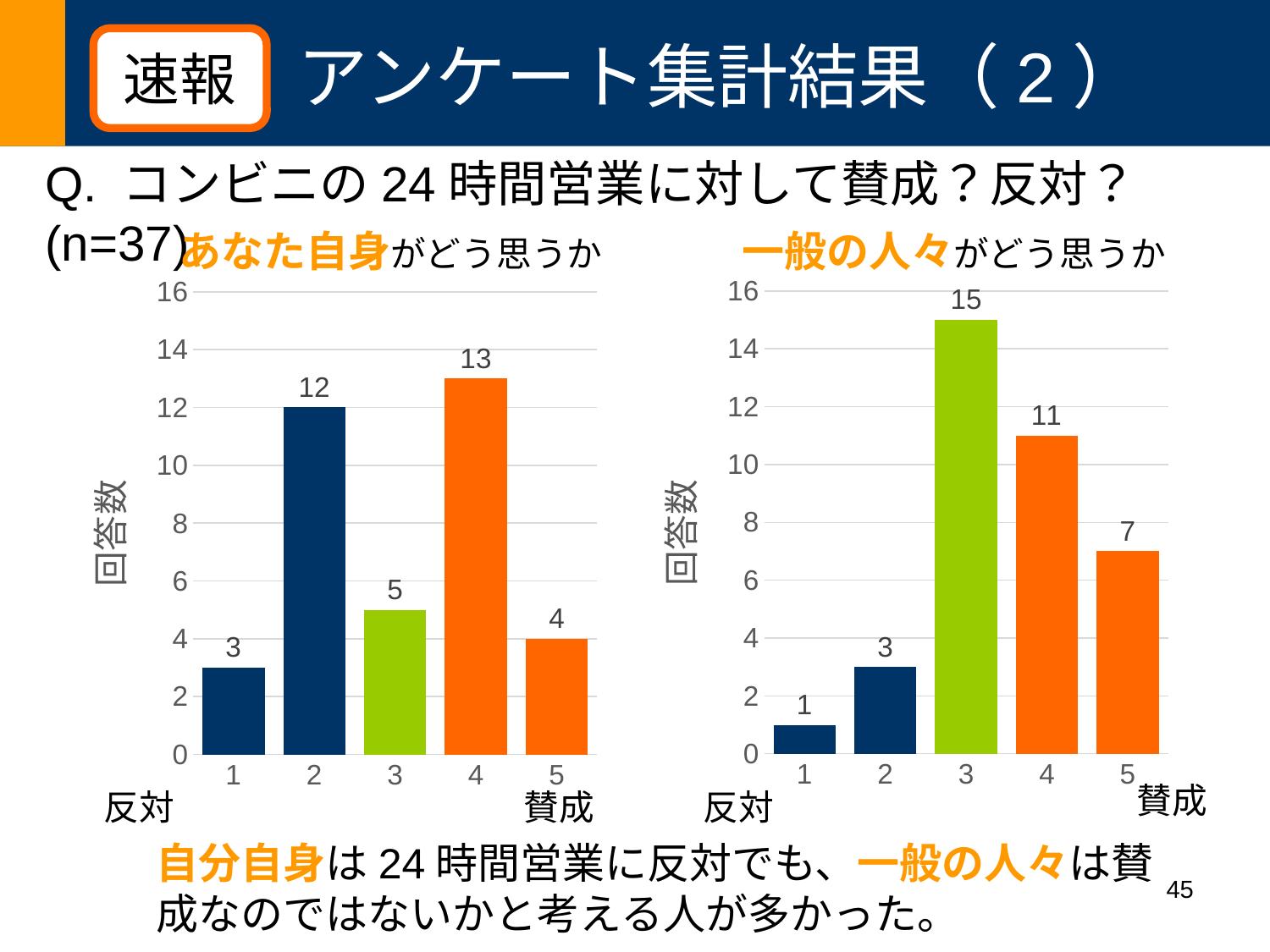
In the right chart (一般の人々がどう思うか), what is the value for category 5? 7 In the left chart (あなた自身がどう思うか), which is larger: the value for category 3 or the value for category 5? category 3 In the left chart (あなた自身がどう思うか), which category has the lowest value? 1 In the left chart (あなた自身がどう思うか), what is the value for category 2? 12 In the right chart (一般の人々がどう思うか), which category has the highest value? 3 In the right chart (一般の人々がどう思うか), what is the difference between the values for category 3 and category 4? 4 In the right chart (一般の人々がどう思うか), which category has the lowest value? 1 How many categories are shown on the x axis of the right chart (一般の人々がどう思うか)? 5 In the left chart (あなた自身がどう思うか), what is the value for category 4? 13 What type of chart is the left chart (あなた自身がどう思うか)? bar chart In the right chart (一般の人々がどう思うか), what is the value for category 3? 15 In the left chart (あなた自身がどう思うか), what is the difference between the values for category 4 and category 2? 1